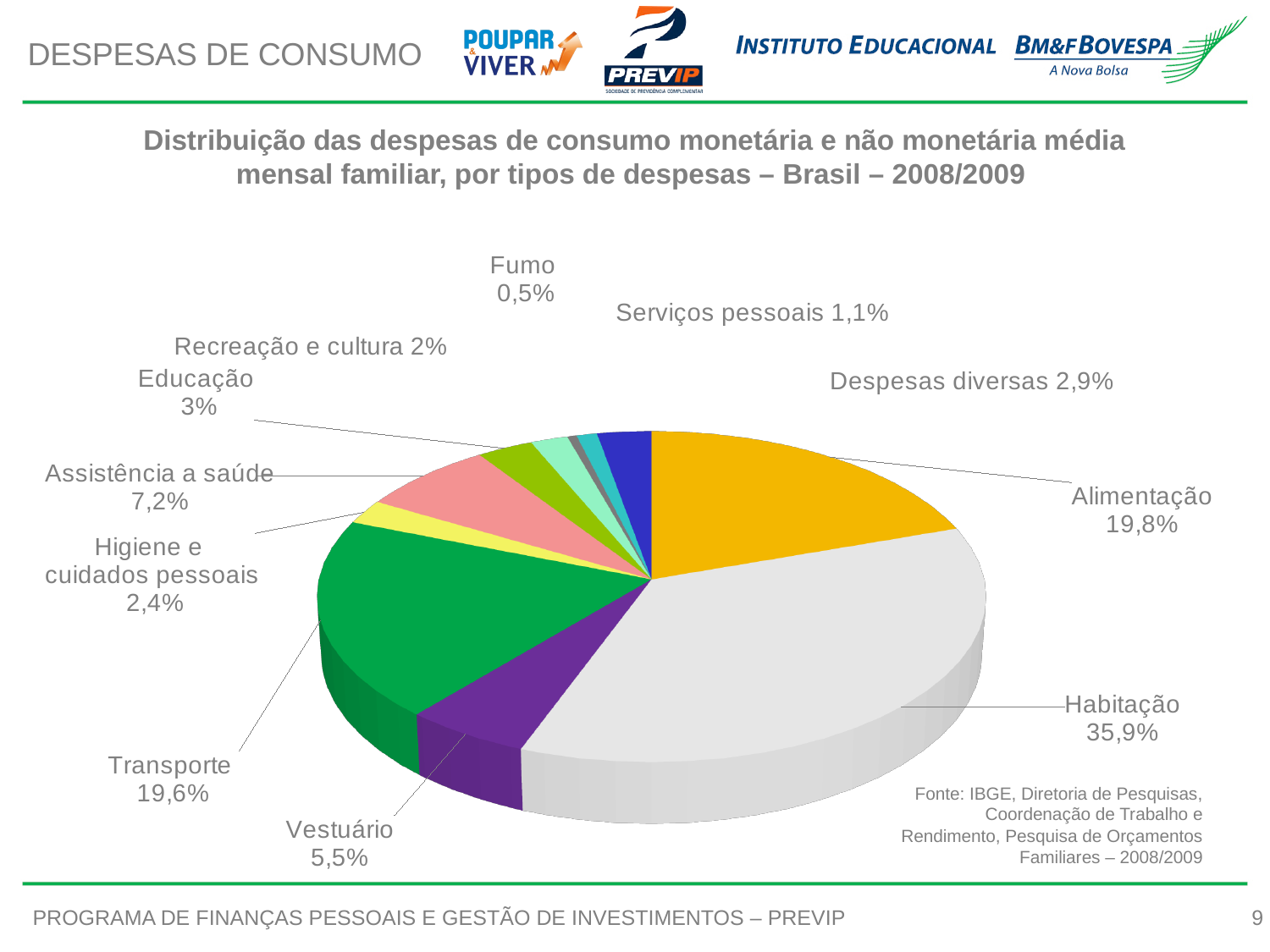
What is the value shown for Fumo? 0,5% What is the difference in percentage points between Habitação and Alimentação? 16,1 Which is larger, the share for Vestuário or the share for Educação? Vestuário What kind of chart is shown on the slide? Pie chart Which category has the smallest share of the pie? Fumo What is the value shown for Transporte? 19,6% Which category has the largest share of the pie? Habitação How many categories are shown in the pie chart? 11 What is the value shown for Assistência a saúde? 7,2% According to the note on the slide, what is the source of the chart data? IBGE What is the difference in percentage points between Despesas diversas and Higiene e cuidados pessoais? 0,5 What share of the pie does Habitação represent? 35,9%